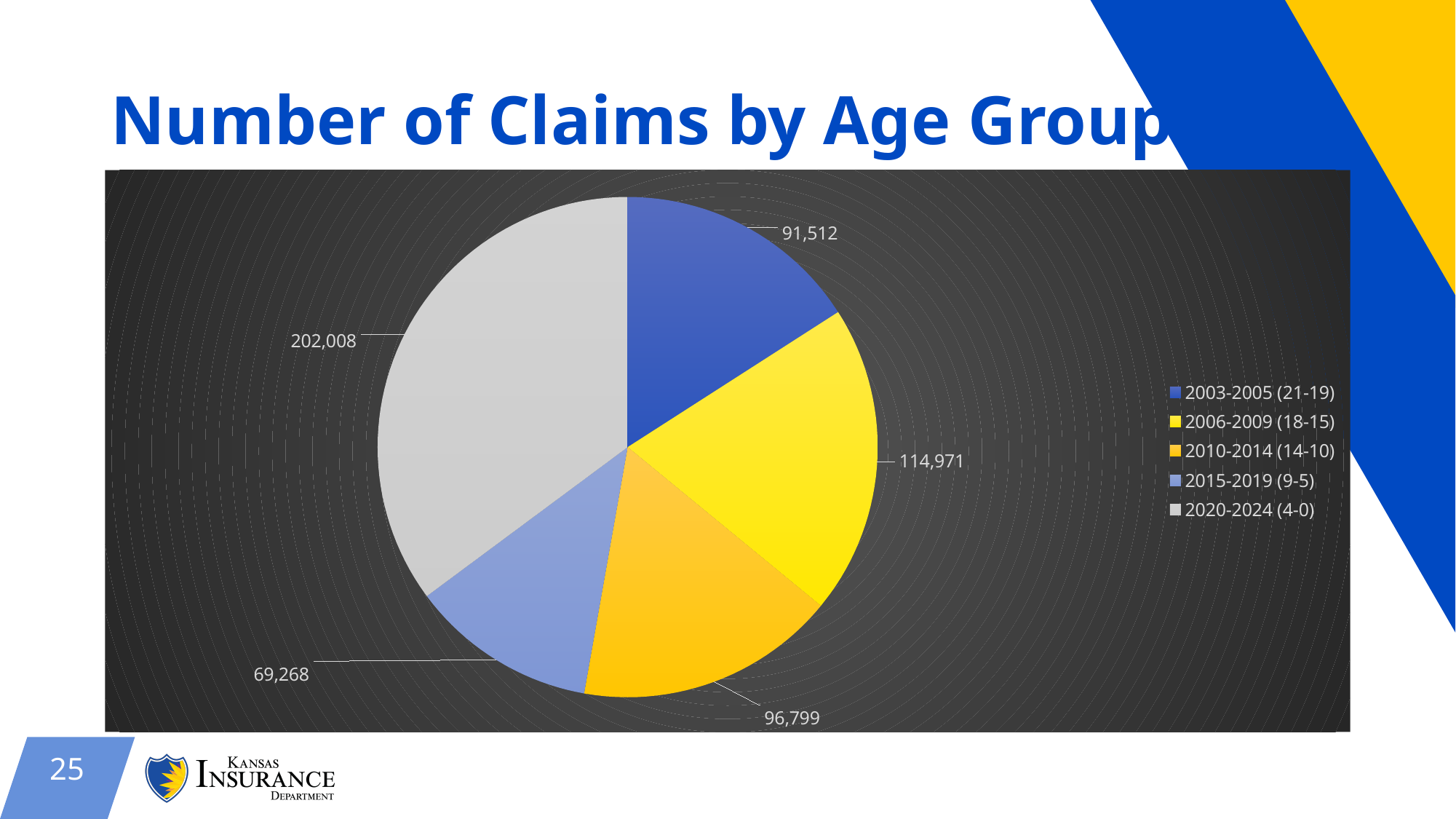
Which age group has the highest number of claims? 2020-2024 (4-0) What is the difference in claims between the 2020-2024 (4-0) group and the 2015-2019 (9-5) group? 132,740 Which has more claims, the 2010-2014 (14-10) group or the 2003-2005 (21-19) group? 2010-2014 (14-10) Which age group has the lowest number of claims? 2015-2019 (9-5) What is the number of claims for the 2020-2024 (4-0) age group? 202,008 What is the number of claims for the 2015-2019 (9-5) age group? 69,268 What type of chart is shown on the slide? Pie chart What is the number of claims for the 2003-2005 (21-19) age group? 91,512 What is the difference in claims between the 2006-2009 (18-15) group and the 2003-2005 (21-19) group? 23,459 How many age groups are shown in the pie chart? 5 What is the title of the chart? Number of Claims by Age Group What is the number of claims for the 2006-2009 (18-15) age group? 114,971